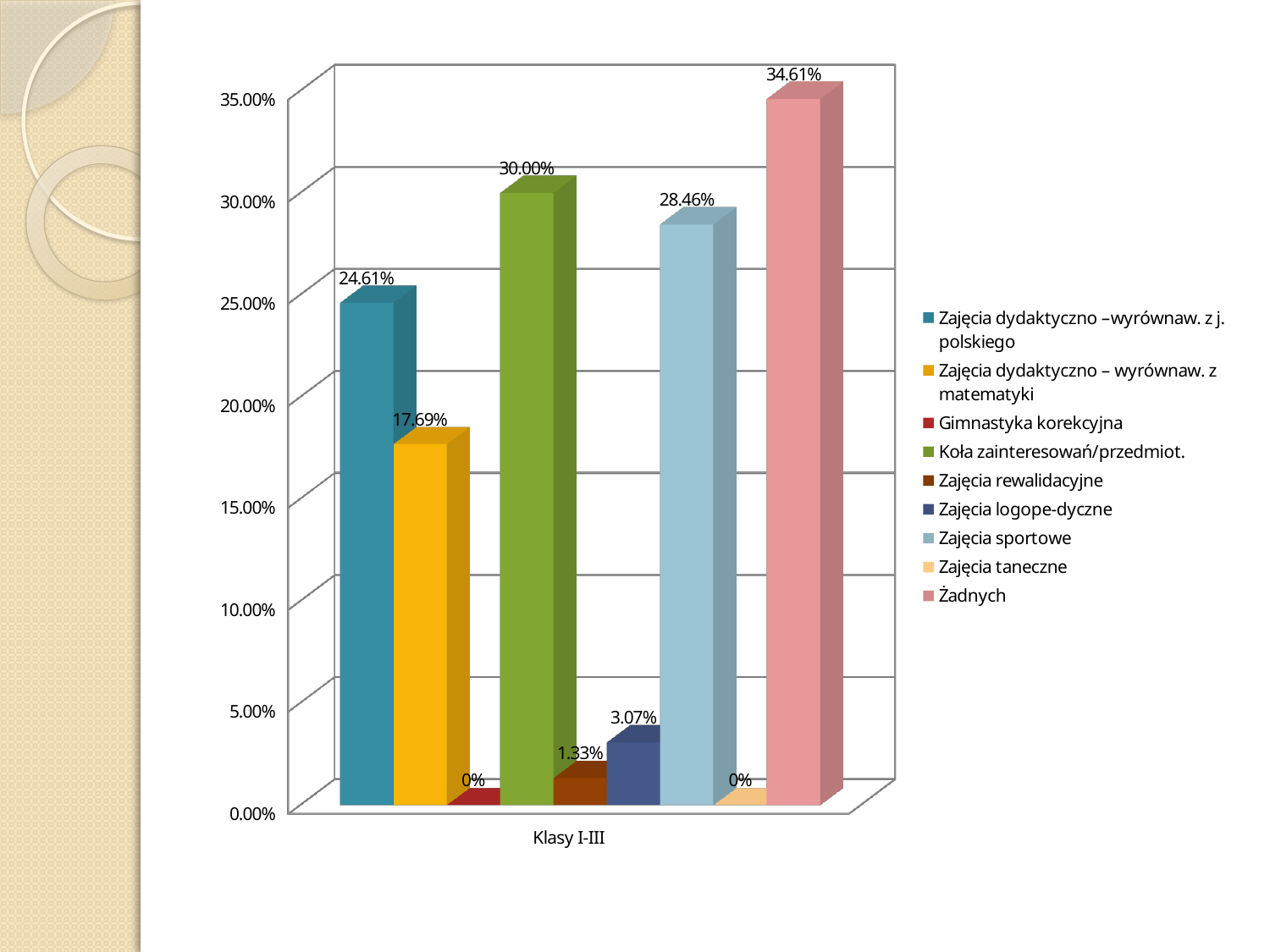
What is the value for Koła zainteresowań/przedmiot.? 30.00% What is the category label shown on the x axis? Klasy I-III What is the difference between the values for Zajęcia dydaktyczno –wyrównaw. z j. polskiego and Zajęcia dydaktyczno – wyrównaw. z matematyki? 6.92% Which series has the highest value? Żadnych Which is larger, the value for Koła zainteresowań/przedmiot. or the value for Zajęcia sportowe? Koła zainteresowań/przedmiot. How many series does the legend list? 9 How many series have a value of 0%? 2 What is the value for Zajęcia rewalidacyjne? 1.33% What is the value for Zajęcia sportowe? 28.46% What is the value for Zajęcia logope-dyczne? 3.07% What is the value for Żadnych? 34.61% What kind of chart is shown on the slide? Bar chart